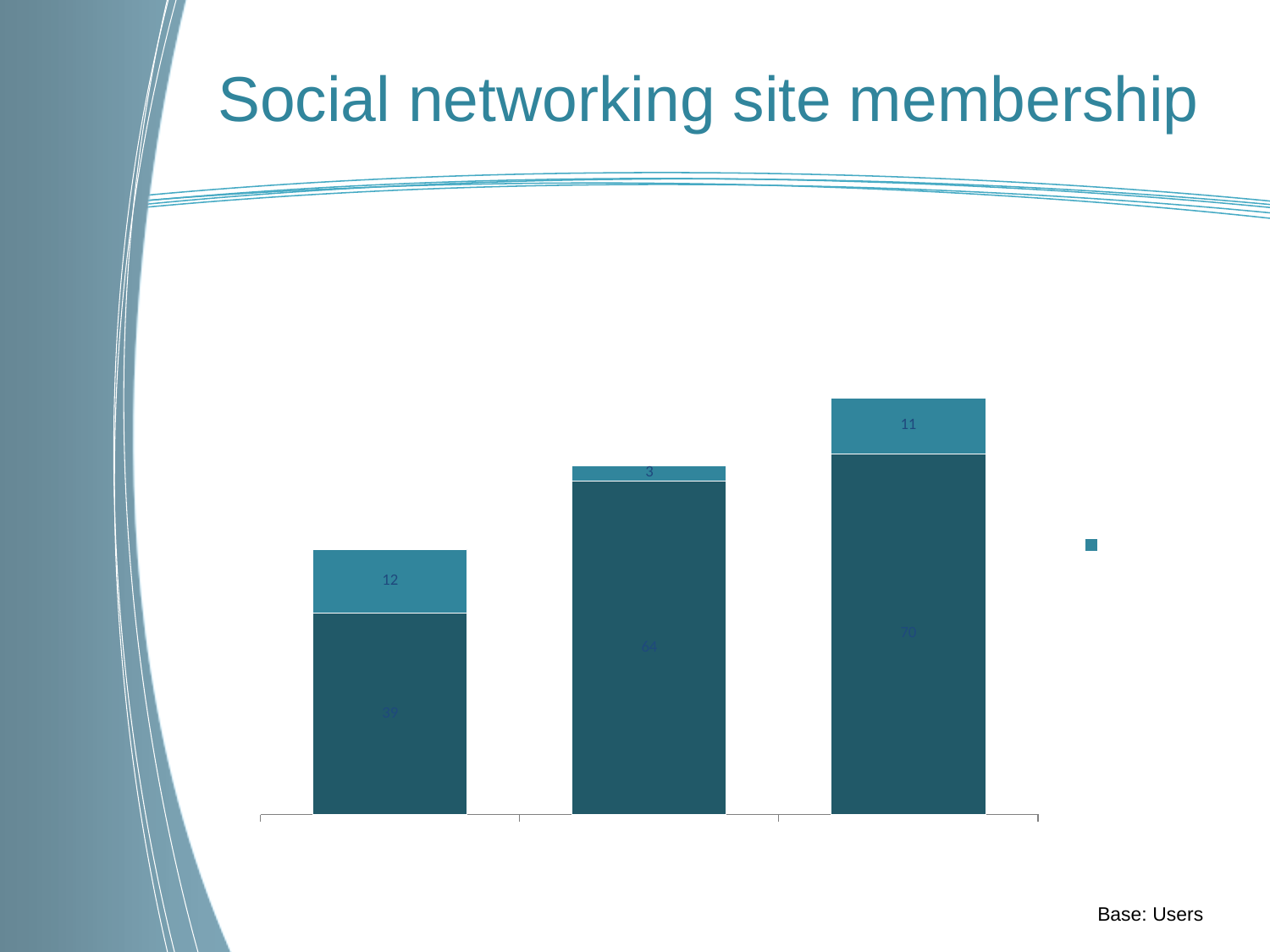
What kind of chart is shown on the slide? bar chart Do the total bar heights rise or fall from left to right? rise Which bar is the tallest overall: left, middle or right? right What is the title of the chart on the slide? Social networking site membership What is the value of the darker bottom segment of the right bar? 70 What is the value of the lighter top segment of the middle bar? 3 How many bars are plotted in the chart? 3 What is the difference between the darker segment of the right bar (70) and the darker segment of the middle bar (64)? 6 What is the value of the lighter top segment of the left bar? 12 What is the total of the two segments in the left bar? 51 Which bar is the shortest overall: left, middle or right? left What is the value of the lighter top segment of the right bar? 11